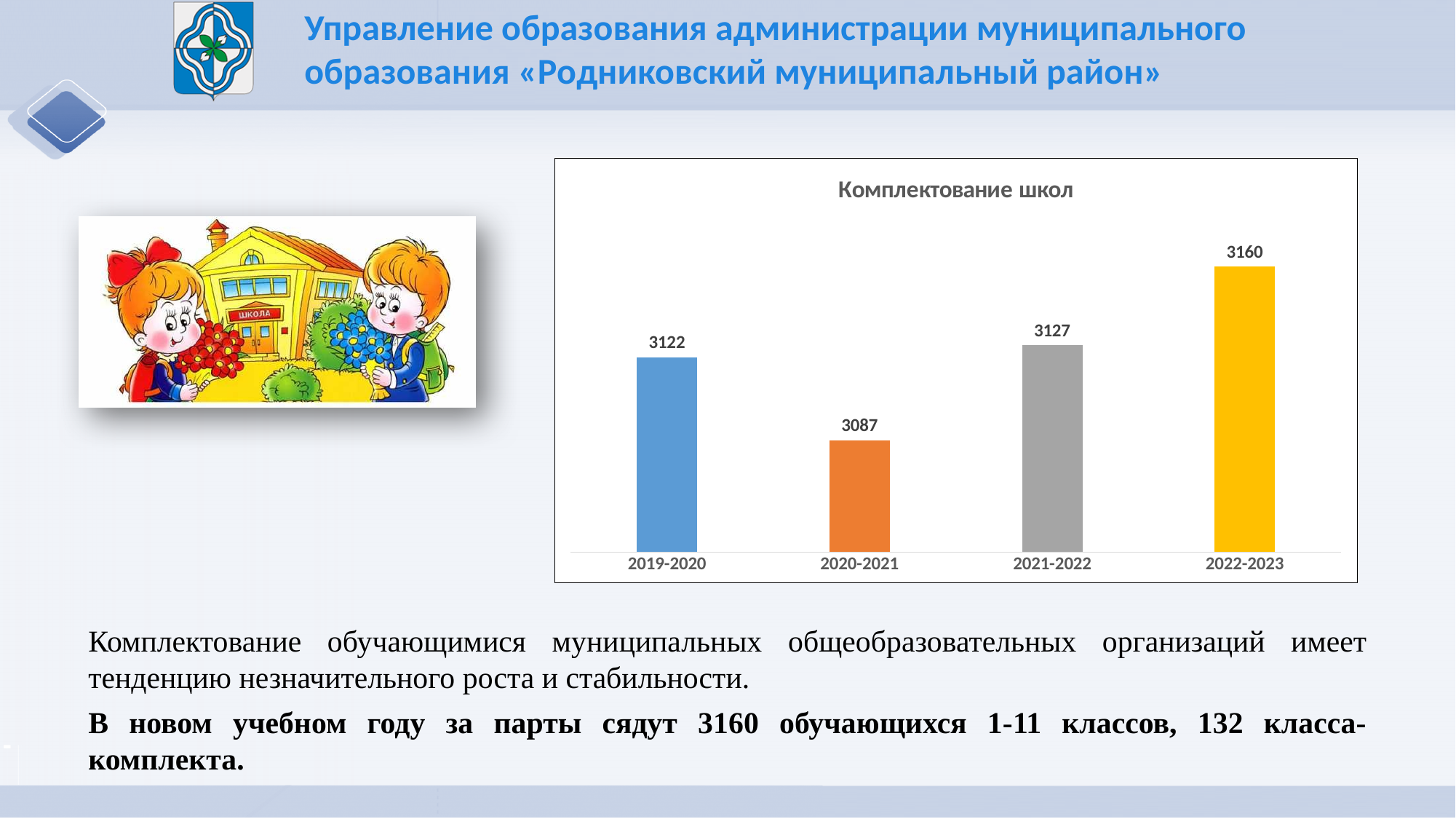
Which school year has the highest value in the chart? 2022-2023 What is the difference between the values for 2021-2022 and 2019-2020? 5 What is the title of the chart? Комплектование школ What kind of chart is shown on the slide? Bar chart Which is larger, the value for 2019-2020 or the value for 2020-2021? 2019-2020 What is the value for 2022-2023 in the chart? 3160 What is the difference between the values for 2022-2023 and 2020-2021? 73 What is the value for 2020-2021 in the chart? 3087 What is the value for 2021-2022 in the chart? 3127 Which school year has the lowest value in the chart? 2020-2021 How many school years are shown in the chart? 4 What is the value for 2019-2020 in the chart? 3122